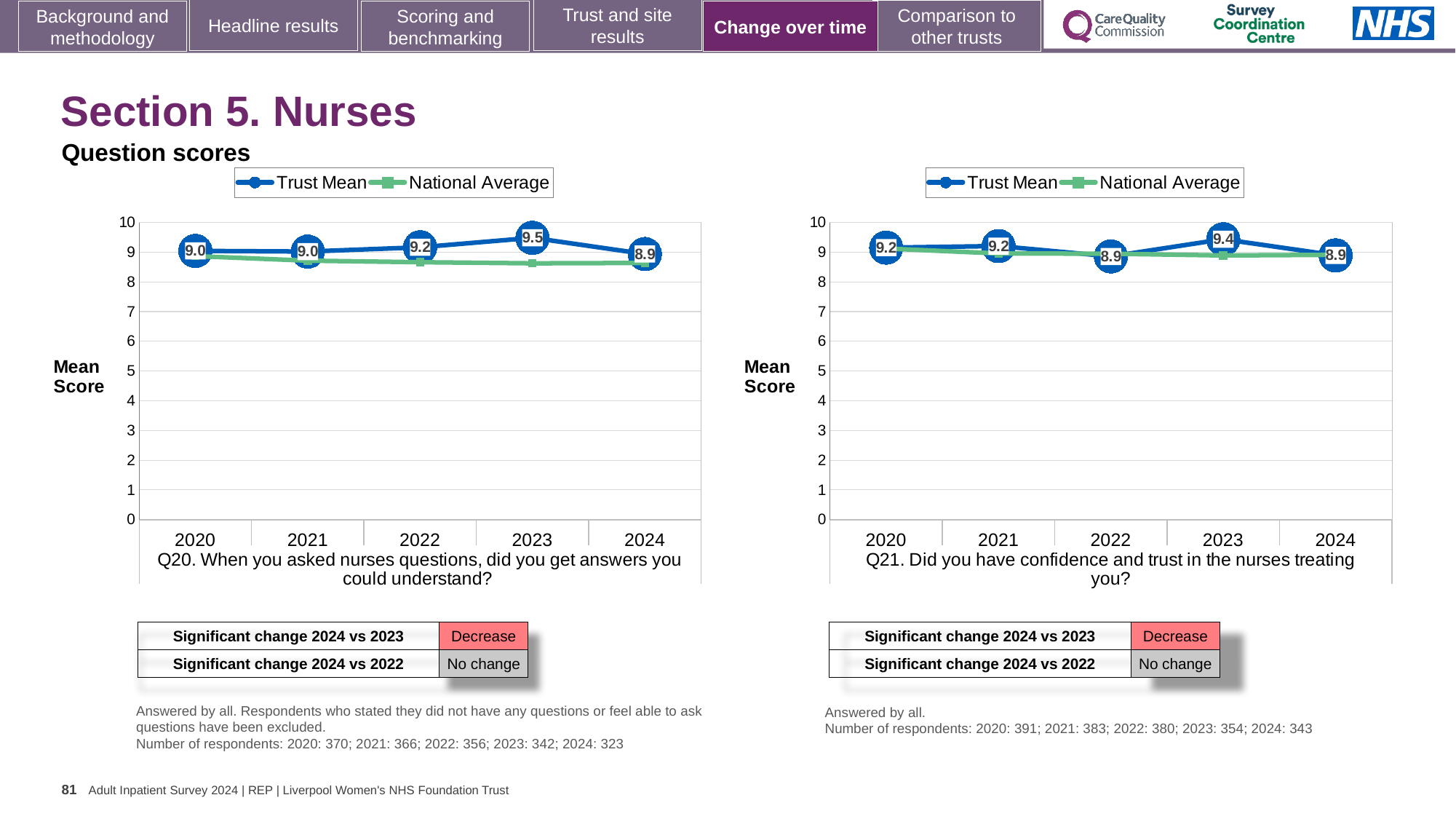
In the Q21 chart (right), which year has the highest Trust Mean score? 2023 In the Q20 chart (left), what is the Trust Mean score for 2024? 8.9 In the Q20 chart (left), which year has the highest Trust Mean score? 2023 In the Q21 chart (right), what is the Trust Mean score for 2022? 8.9 In the Q20 chart (left), what is the Trust Mean score for 2023? 9.5 In the Q20 chart (left), is the Trust Mean score for 2022 larger or smaller than the Trust Mean score for 2023? smaller In the Q21 chart (right), what is the difference between the Trust Mean scores for 2023 and 2022? 0.5 In the Q21 chart (right), is the National Average for 2024 greater or less than 8? greater How many years are plotted on the x axis of the Q20 chart (left)? 5 How many series does the legend of the Q21 chart (right) list? 2 In the Q20 chart (left), what is the difference between the Trust Mean scores for 2023 and 2024? 0.6 In the Q21 chart (right), what is the Trust Mean score for 2020? 9.2